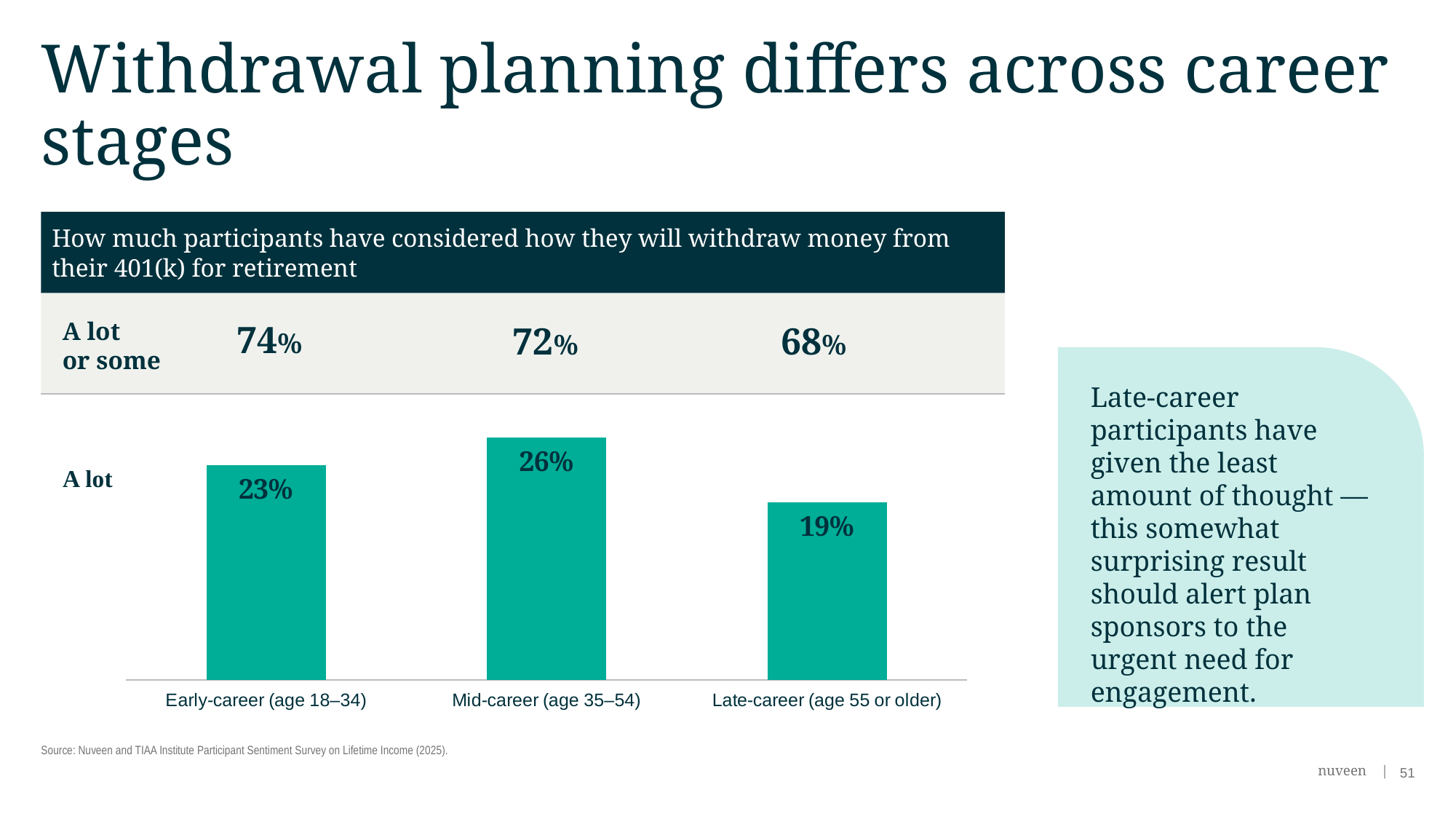
Which is larger: the 'a lot' value for early-career participants or for late-career participants? Early-career (age 18–34) What percentage of early-career participants have considered 'a lot or some' how they will withdraw money from their 401(k)? 74% What percentage of early-career participants (age 18–34) have considered 'a lot' how they will withdraw money from their 401(k)? 23% What percentage of late-career participants have considered 'a lot or some' how they will withdraw money from their 401(k)? 68% Which career stage has the highest share of participants who have considered 'a lot' how they will withdraw money? Mid-career (age 35–54) What is the difference in percentage points between early-career and late-career participants who have considered 'a lot or some'? 6 percentage points How many career-stage categories are shown in the bar chart? 3 What percentage of late-career participants (age 55 or older) have considered 'a lot' how they will withdraw money from their 401(k)? 19% What percentage of mid-career participants (age 35–54) have considered 'a lot' how they will withdraw money from their 401(k)? 26% What is the difference in percentage points between mid-career and late-career participants who have considered 'a lot'? 7 percentage points Which career stage has the lowest share of participants who have considered 'a lot' how they will withdraw money? Late-career (age 55 or older) What type of chart is used to show the 'a lot' values? Bar chart